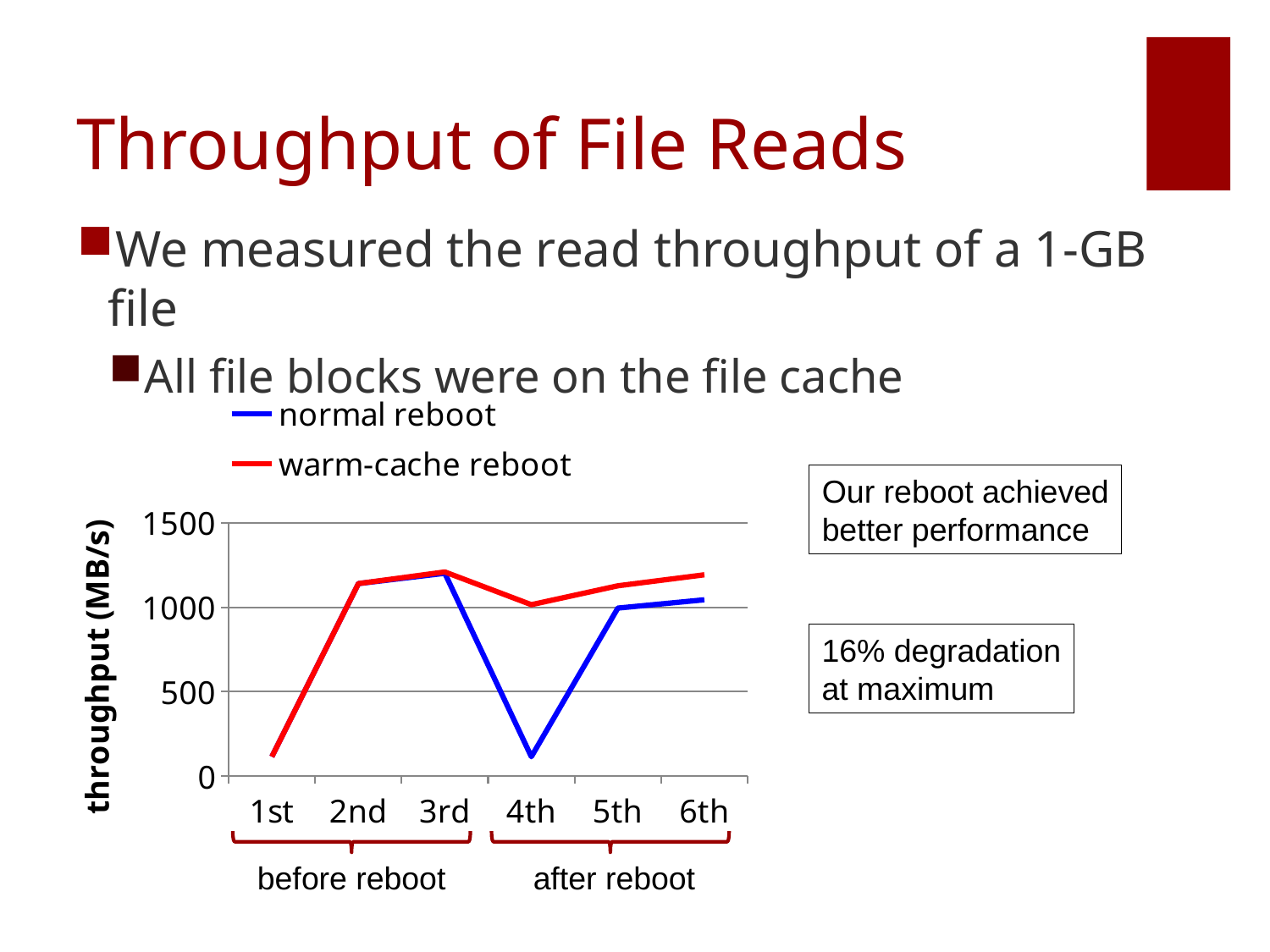
Is the value for warm-cache reboot at the 1st measurement greater or less than 500? less How many series does the chart's legend list? 2 Is the value for normal reboot at the 4th measurement greater or less than 500? less What colour is the warm-cache reboot line? red At the 5th measurement, which series has the larger value, normal reboot or warm-cache reboot? warm-cache reboot Is the value for warm-cache reboot at the 4th measurement greater or less than 500? greater Does the normal reboot series rise or fall from the 3rd to the 4th measurement? fall At the 4th measurement, which series has the larger value, normal reboot or warm-cache reboot? warm-cache reboot What kind of chart is shown on the slide? line chart How many points are plotted along the x axis for each series? 6 What is the label of the y axis? throughput (MB/s)